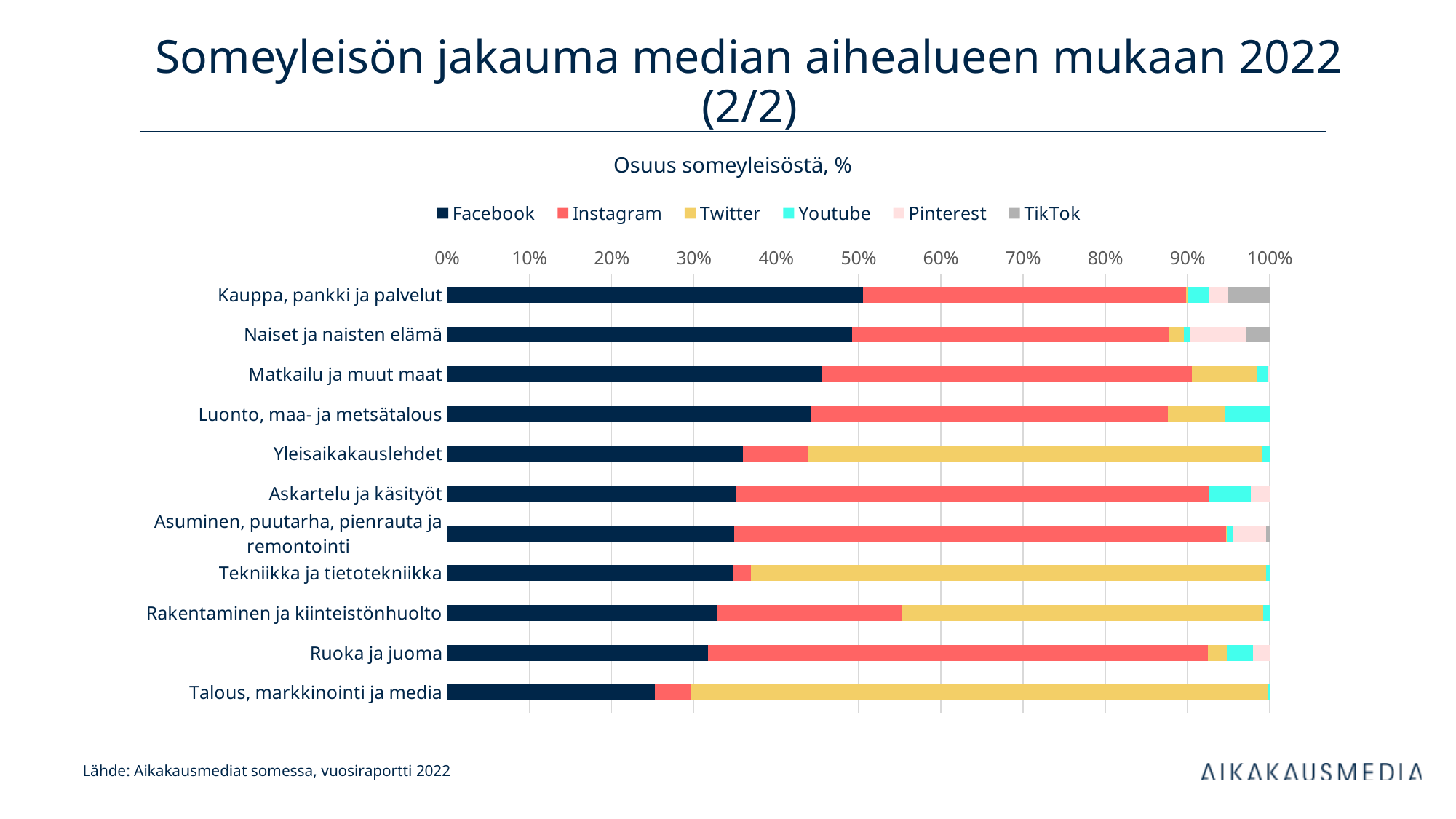
How many series does the legend list? 6 Which has the larger Facebook share: Kauppa, pankki ja palvelut or Talous, markkinointi ja media? Kauppa, pankki ja palvelut Is the Facebook share for Kauppa, pankki ja palvelut greater or less than 40%? greater Which series is listed last in the legend? TikTok Which has the larger Twitter share: Talous, markkinointi ja media or Rakentaminen ja kiinteistönhuolto? Talous, markkinointi ja media Is the Facebook share for Luonto, maa- ja metsätalous greater or less than 50%? less What kind of chart is shown on the slide? Stacked bar chart What is the axis title shown above the legend? Osuus someyleisöstä, % How many categories (media topic areas) are plotted on the chart? 11 Which category has the largest Twitter share? Talous, markkinointi ja media Which category has the smallest Facebook share? Talous, markkinointi ja media Is the Facebook share for Talous, markkinointi ja media greater or less than 30%? less